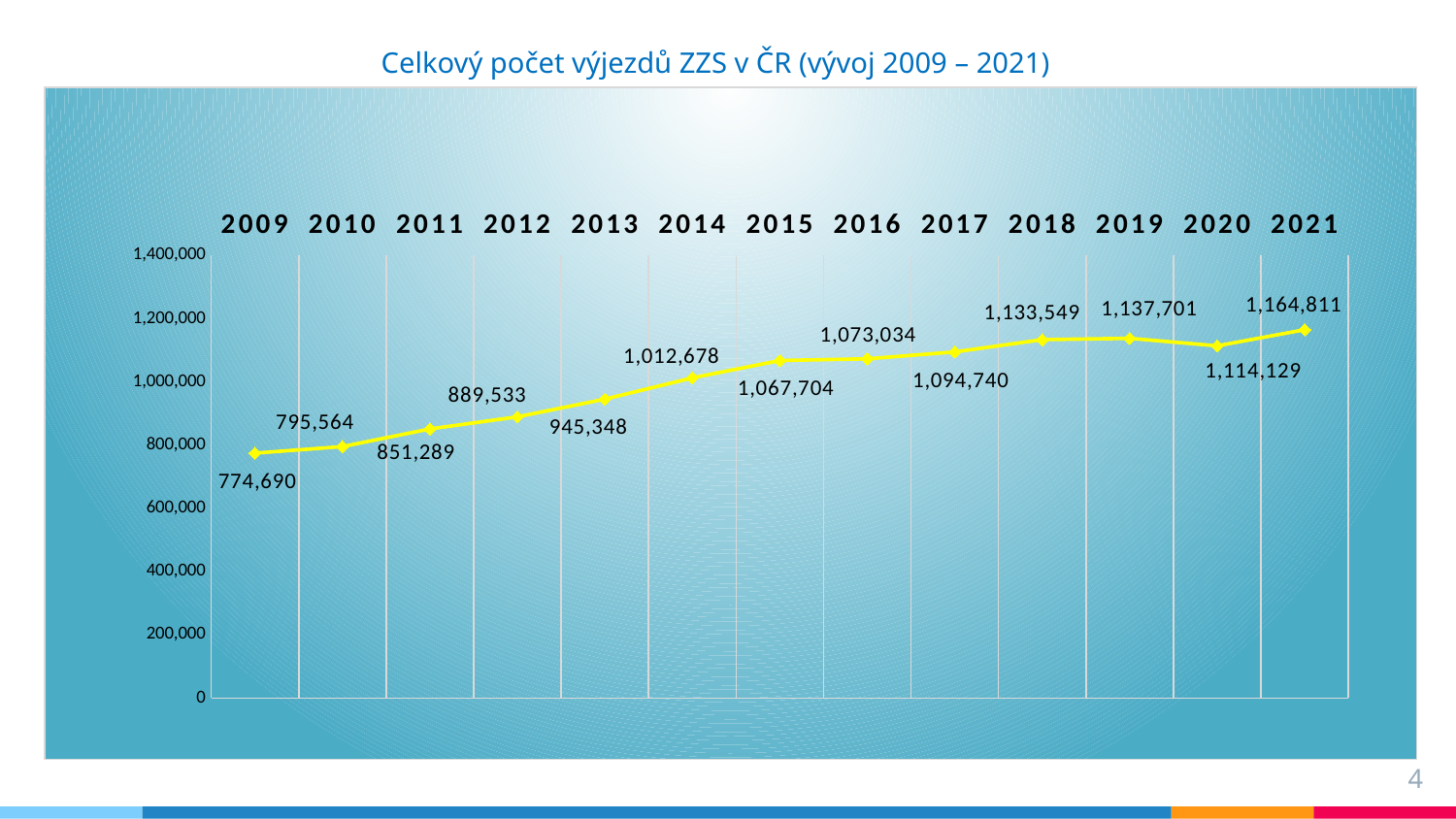
Do the values generally rise or fall from 2009 to 2021? rise How many years are plotted on the chart? 13 What kind of chart is shown? line chart Which year has the lowest value? 2009 Which is larger, the value for 2019 or the value for 2020? 2019 Which year has the highest value? 2021 What is the value for 2009? 774,690 What is the difference between the values for 2019 and 2020? 23,572 What is the value for 2020? 1,114,129 What is the difference between the values for 2021 and 2009? 390,121 Is the value for 2013 greater or less than 1,000,000? less What is the value for 2014? 1,012,678